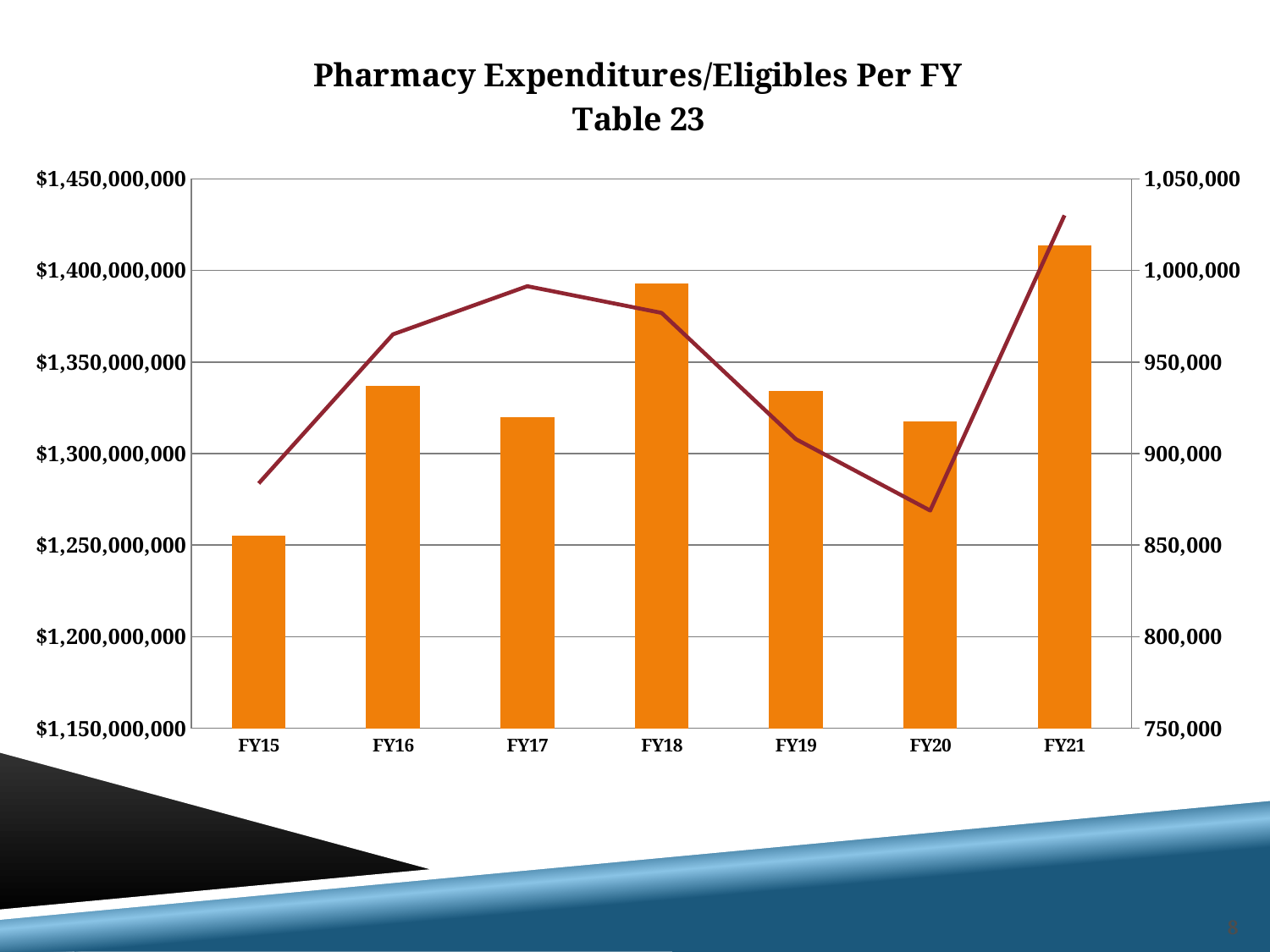
What kind of chart is shown on the slide? A bar chart with a line overlaid Which bar is taller, FY16 or FY17? FY16 Is the bar for FY21 greater or less than $1,400,000,000? greater Which fiscal year has the tallest bar? FY21 Is the bar for FY15 greater or less than $1,300,000,000? less Do the bars rise or fall from FY18 to FY20? fall Is the line value for FY21 (right axis) greater or less than 1,000,000? greater What is the title of the chart? Pharmacy Expenditures/Eligibles Per FY Table 23 How many fiscal years are shown on the x axis? 7 Which fiscal year has the shortest bar? FY15